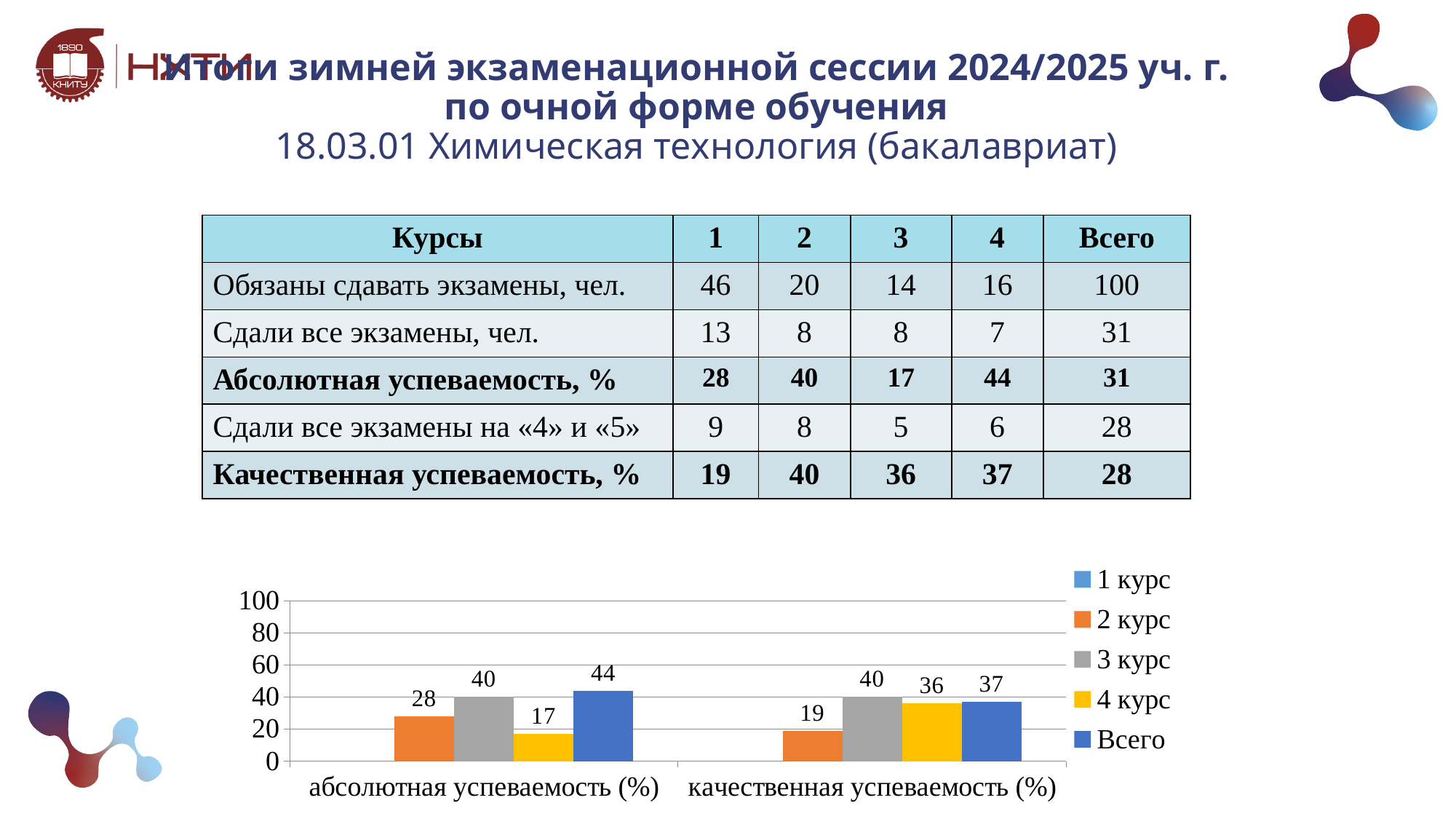
What is the lowest labeled value in the качественная успеваемость (%) group? 19 What value is labeled on the orange bar in the абсолютная успеваемость (%) group? 28 What is the difference between the highest and lowest labeled values in the абсолютная успеваемость (%) group? 27 Is the tallest bar in the абсолютная успеваемость (%) group greater or less than 40? greater Which legend entry is shown in orange? 2 курс How many series does the chart legend list? 5 What is the lowest labeled value in the абсолютная успеваемость (%) group? 17 How many categories are shown on the x axis of the chart? 2 What is the highest labeled value in the качественная успеваемость (%) group? 40 Which group has the taller tallest bar: абсолютная успеваемость (%) or качественная успеваемость (%)? абсолютная успеваемость (%) What kind of chart is shown at the bottom of the slide? bar chart What is the highest labeled value in the абсолютная успеваемость (%) group? 44